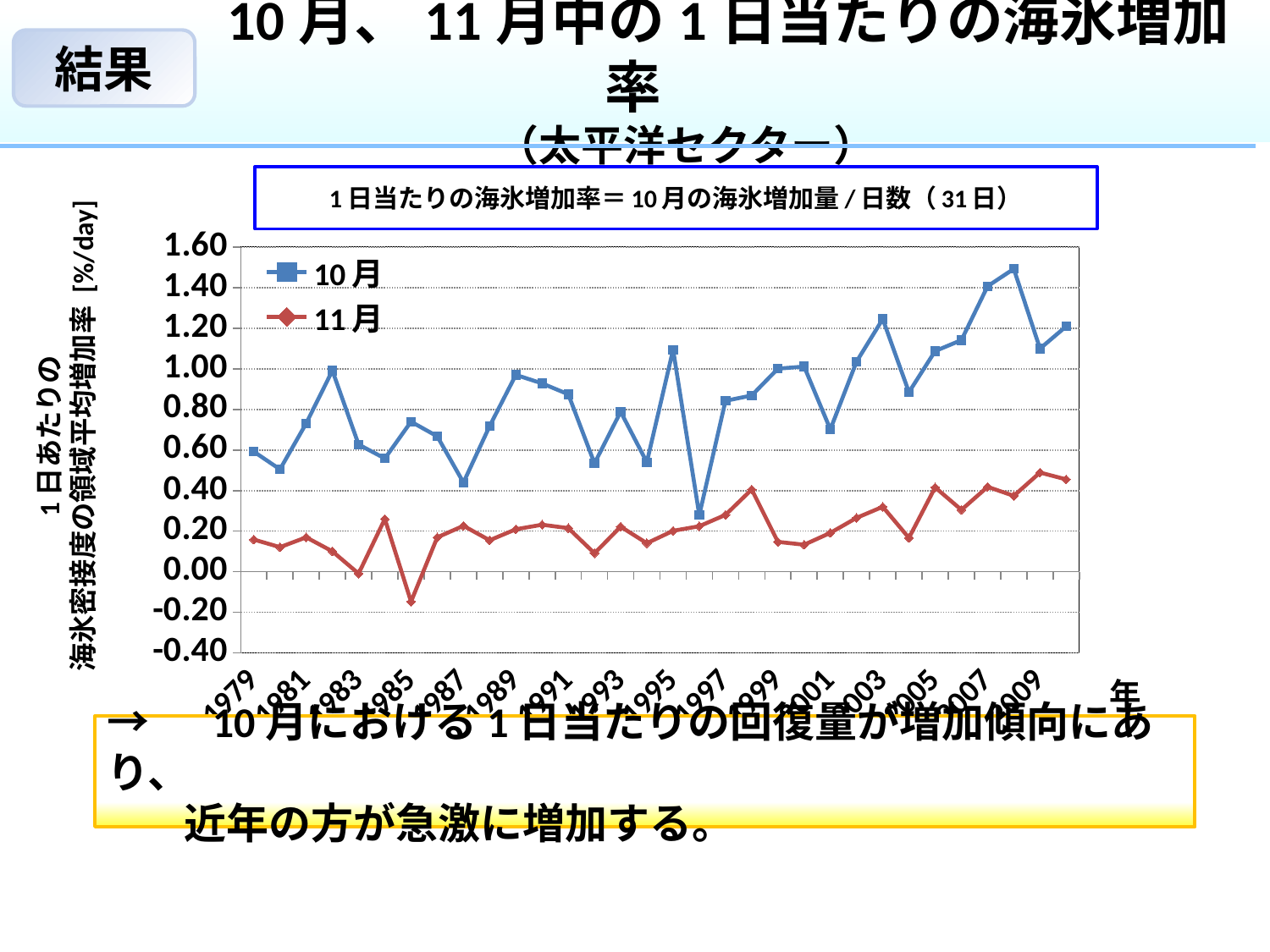
What are the two series named in the legend? 10月 and 11月 Is the value for 11月 in 1985 greater or less than 0.00? less In which year does the 11月 series reach its lowest value? 1985 How many series does the legend list? 2 Is the value for 10月 in 1997 greater or less than 0.40? greater In which year does the 10月 series reach its highest value? 2008 Which series has the larger value in 1995, 10月 or 11月? 10月 Is the value for 10月 in 2008 greater or less than 1.40? greater In which year does the 10月 series reach its lowest value? 1996 What kind of chart is shown on the slide? line chart Does the 10月 series generally rise or fall from 1979 to 2009? rise What is the highest value shown on the y axis? 1.60